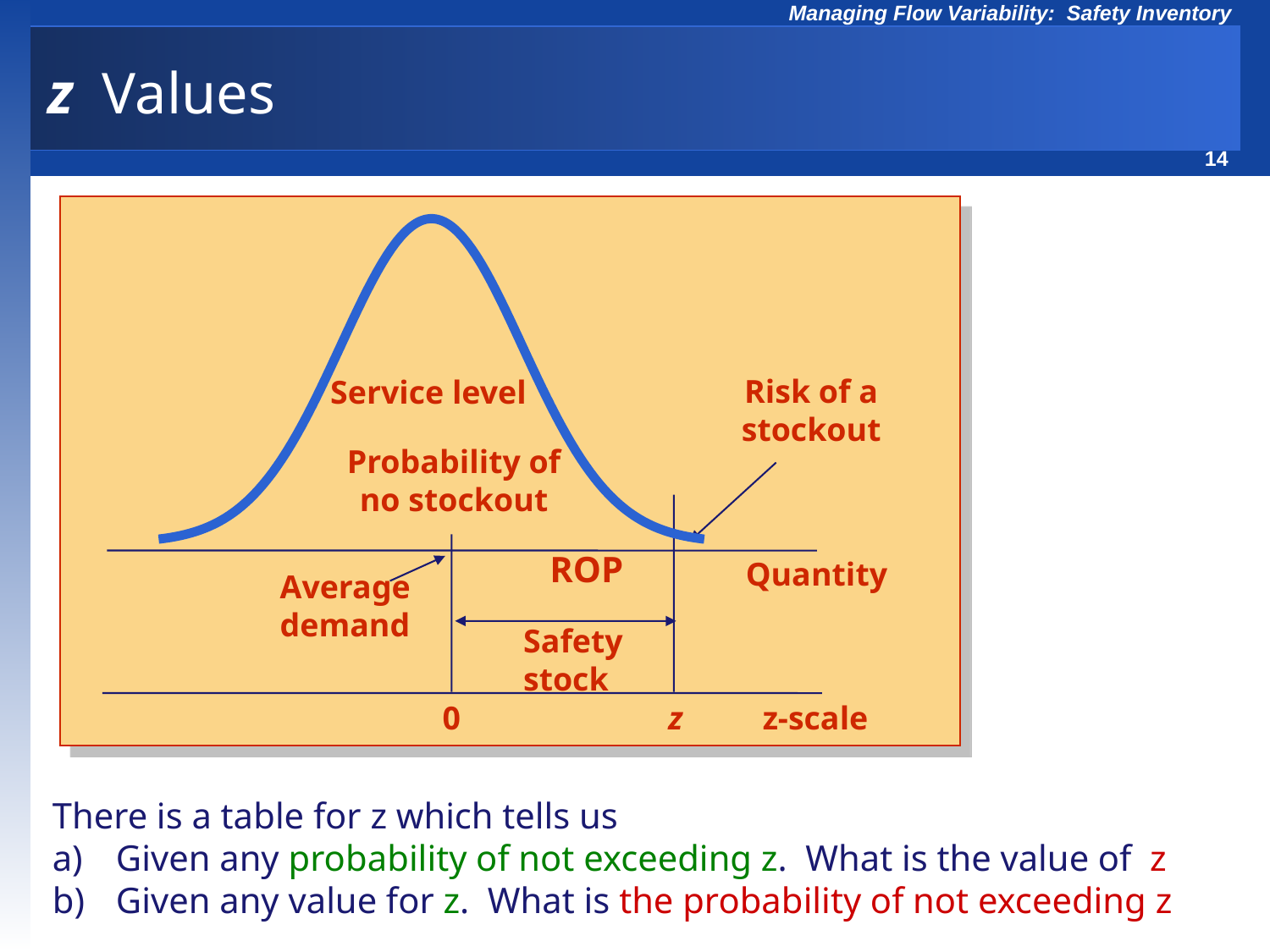
What does the double-headed arrow between the average demand line and the ROP line represent? Safety stock What kind of chart is shown in the diagram on the slide? A line chart (bell-shaped normal distribution curve) On the z-scale axis, what value is marked directly below the average demand? 0 What label is printed on the quantity axis at the position of the vertical line marked z? ROP What does the label pointing to the right tail of the curve say? Risk of a stockout